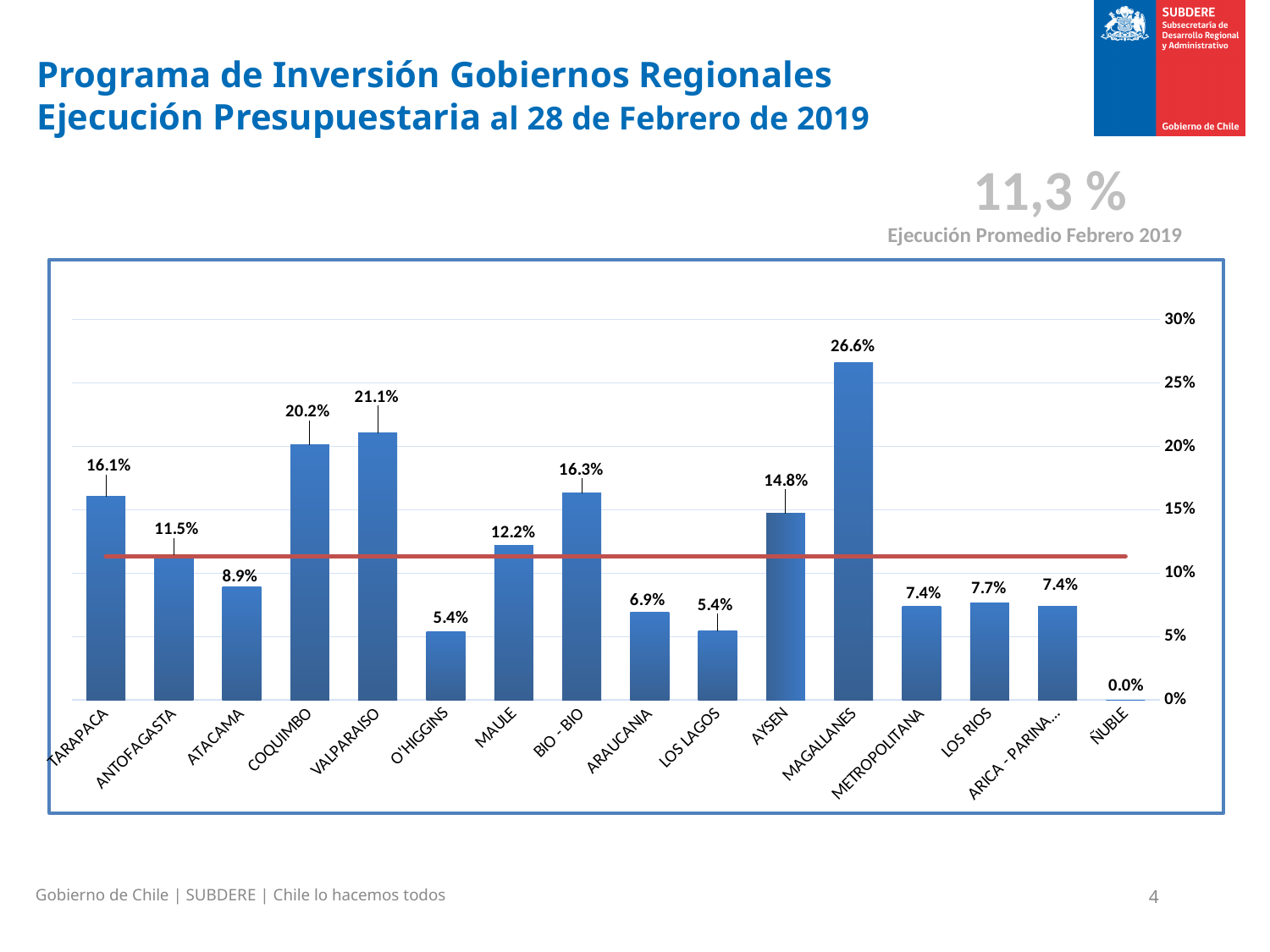
Which is larger, the value for TARAPACA or the value for BIO - BIO? BIO - BIO What is the value for COQUIMBO? 20.2% How many regions are shown on the x axis? 16 What is the value for ÑUBLE? 0.0% What average value does the slide state for Ejecución Promedio Febrero 2019? 11,3 % Which region has the lowest value? ÑUBLE What kind of chart is shown on the slide? Bar chart What is the value for MAGALLANES? 26.6% Is the value for AYSEN greater or less than 10%? greater What is the difference between the values for VALPARAISO and COQUIMBO? 0.9% What is the difference between the values for MAGALLANES and AYSEN? 11.8% Which region has the highest value? MAGALLANES